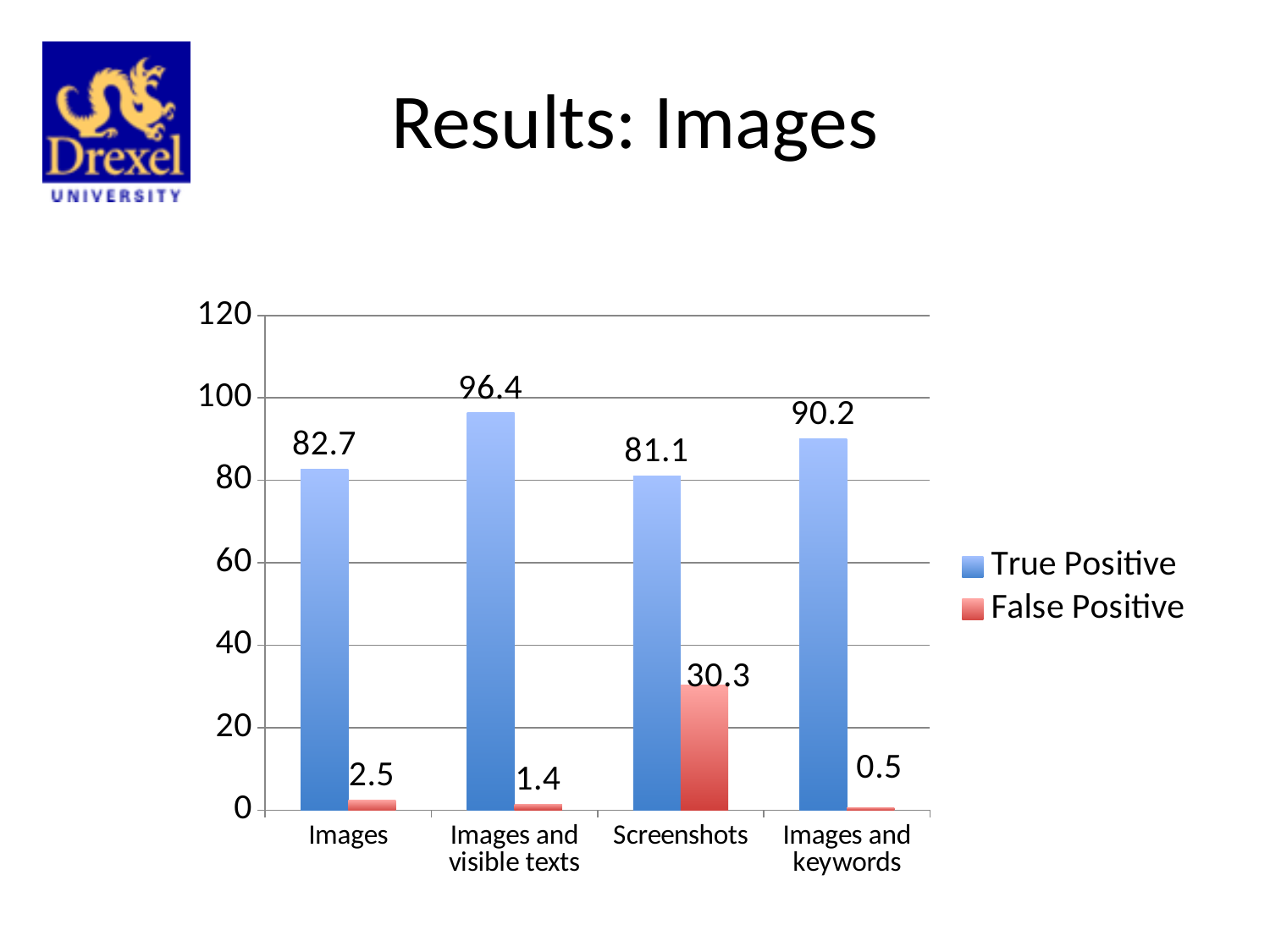
What kind of chart is shown on the slide? Bar chart What is the False Positive value for Screenshots? 30.3 Which category has the highest True Positive value? Images and visible texts What is the difference between the True Positive and False Positive values for Screenshots? 50.8 Which is larger, the True Positive value for Images or the True Positive value for Screenshots? Images What is the False Positive value for Images? 2.5 What is the True Positive value for Images and keywords? 90.2 Which category has the lowest False Positive value? Images and keywords What is the True Positive value for Images and visible texts? 96.4 How many series does the legend list? 2 What colour are the False Positive bars? Red How many categories are shown on the x axis? 4